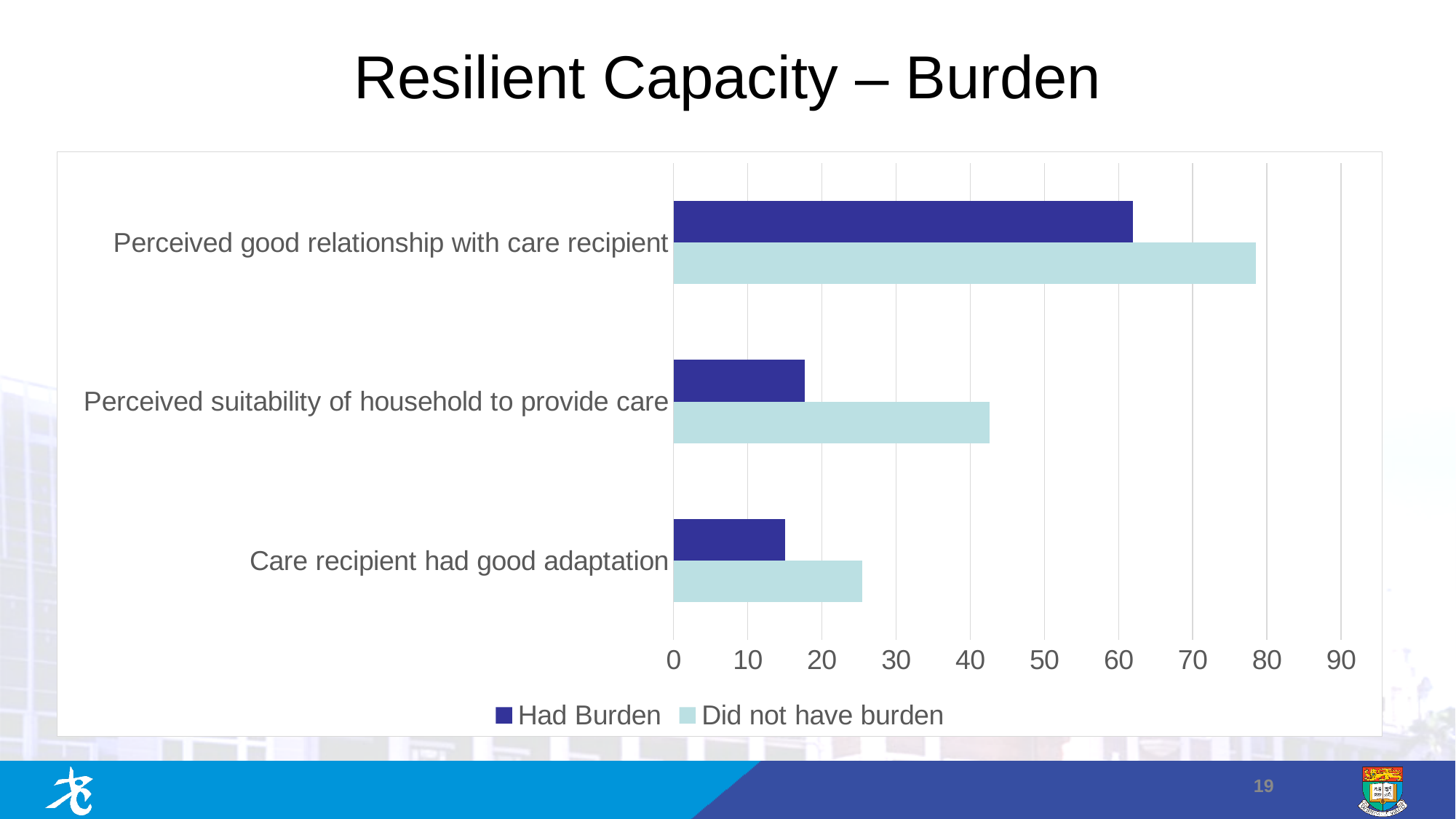
How many series does the legend list? 2 Which category has the lowest value for Had Burden? Care recipient had good adaptation How many categories are shown on the chart? 3 Which category has the highest value for Did not have burden? Perceived good relationship with care recipient Is the Had Burden value for Perceived suitability of household to provide care greater or less than 20? less What kind of chart is shown on the slide? bar chart What is the title of the slide containing the chart? Resilient Capacity – Burden Is the Did not have burden value for Care recipient had good adaptation greater or less than 20? greater For Perceived suitability of household to provide care, which series has the larger value, Had Burden or Did not have burden? Did not have burden Which series is shown in dark blue in the legend? Had Burden Is the Did not have burden value for Perceived good relationship with care recipient greater or less than 80? less